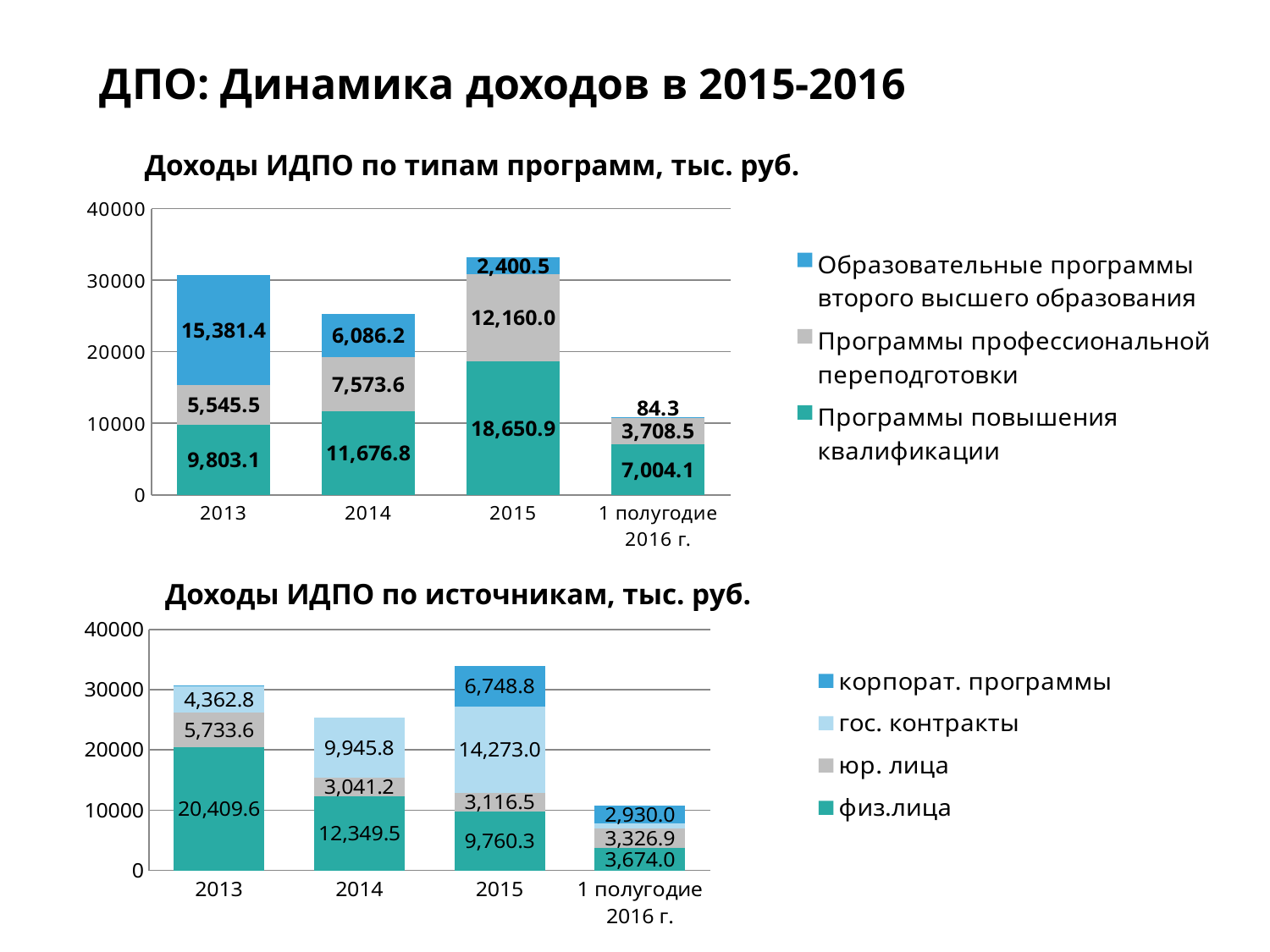
How many series does the legend of the chart 'Доходы ИДПО по источникам, тыс. руб.' list? 4 In the chart 'Доходы ИДПО по типам программ, тыс. руб.', what is the value for Программы профессиональной переподготовки in 2014? 7,573.6 In the chart 'Доходы ИДПО по типам программ, тыс. руб.', what is the value for Программы повышения квалификации in 2015? 18,650.9 How many periods are shown on the x axis of the chart 'Доходы ИДПО по типам программ, тыс. руб.'? 4 In the chart 'Доходы ИДПО по типам программ, тыс. руб.', which period has the highest value for Программы повышения квалификации? 2015 In the chart 'Доходы ИДПО по источникам, тыс. руб.', is the total height of the bar for 1 полугодие 2016 г. greater or less than 10000? greater In the chart 'Доходы ИДПО по типам программ, тыс. руб.', what is the total of the stacked bar for 2013? 30,730.0 In the chart 'Доходы ИДПО по типам программ, тыс. руб.', what is the difference between the 2013 and 2014 values for Образовательные программы второго высшего образования? 9,295.2 In the chart 'Доходы ИДПО по источникам, тыс. руб.', what is the value for физ.лица in 2013? 20,409.6 How many series does the legend of the chart 'Доходы ИДПО по типам программ, тыс. руб.' list? 3 In the chart 'Доходы ИДПО по источникам, тыс. руб.', what is the value for гос. контракты in 2015? 14,273.0 In the chart 'Доходы ИДПО по источникам, тыс. руб.', which is larger in 2014: гос. контракты or юр. лица? гос. контракты